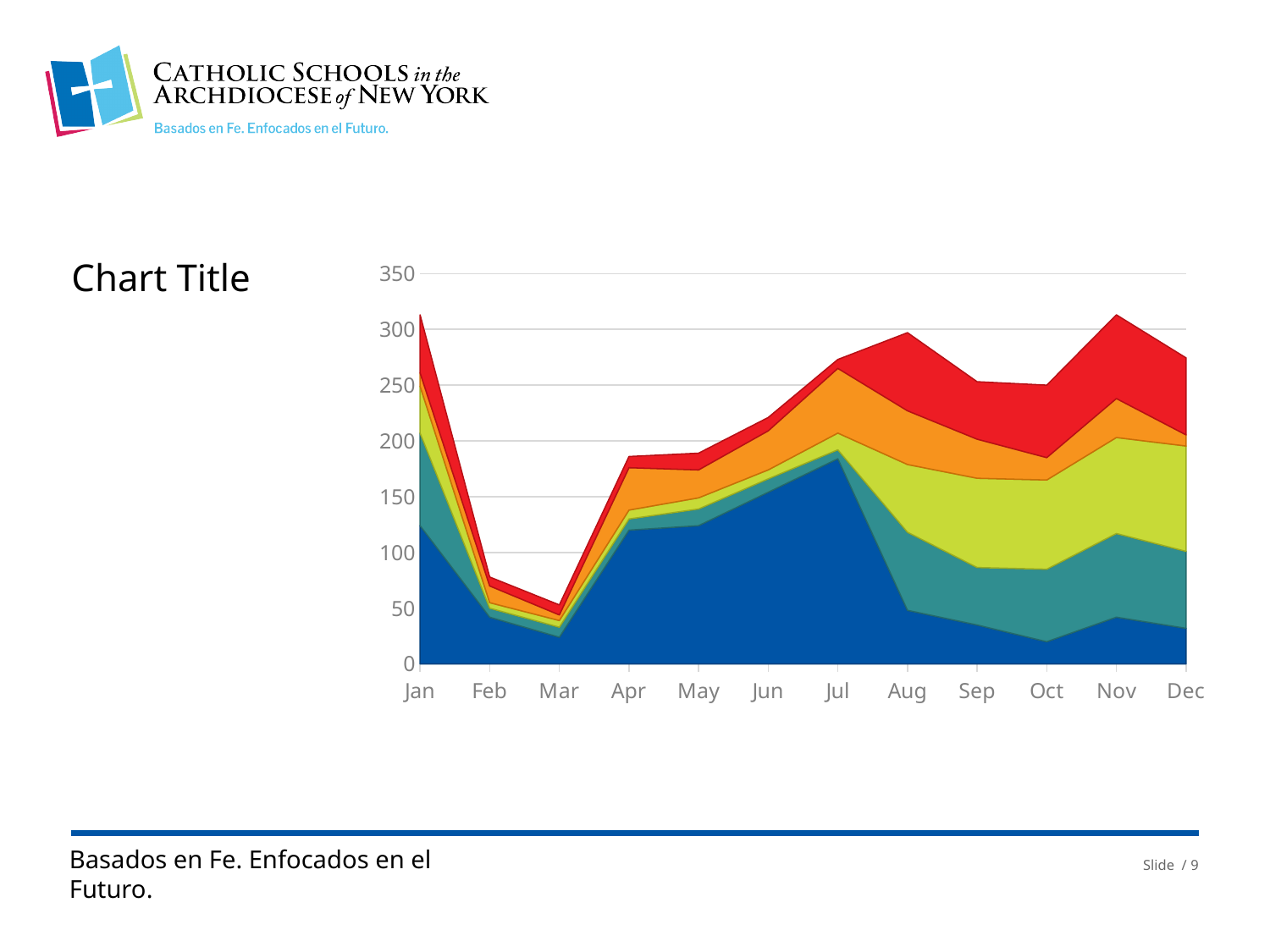
Does the total stacked value rise or fall from Mar to Jul? rise Is the total stacked value for Mar greater or less than 100? less Is the value of the bottom (dark blue) band for Jul greater or less than 150? greater Is the value of the bottom (dark blue) band for Oct greater or less than 50? less How many months are shown along the x axis of the chart? 12 What kind of chart is shown on the slide? stacked area chart In which month is the total height of the stacked areas lowest? Mar How many coloured bands (series) are stacked in the chart? 5 Which month has the larger total stacked value, Aug or Sep? Aug In which month does the bottom (dark blue) band reach its highest value? Jul What is the title of the chart? Chart Title